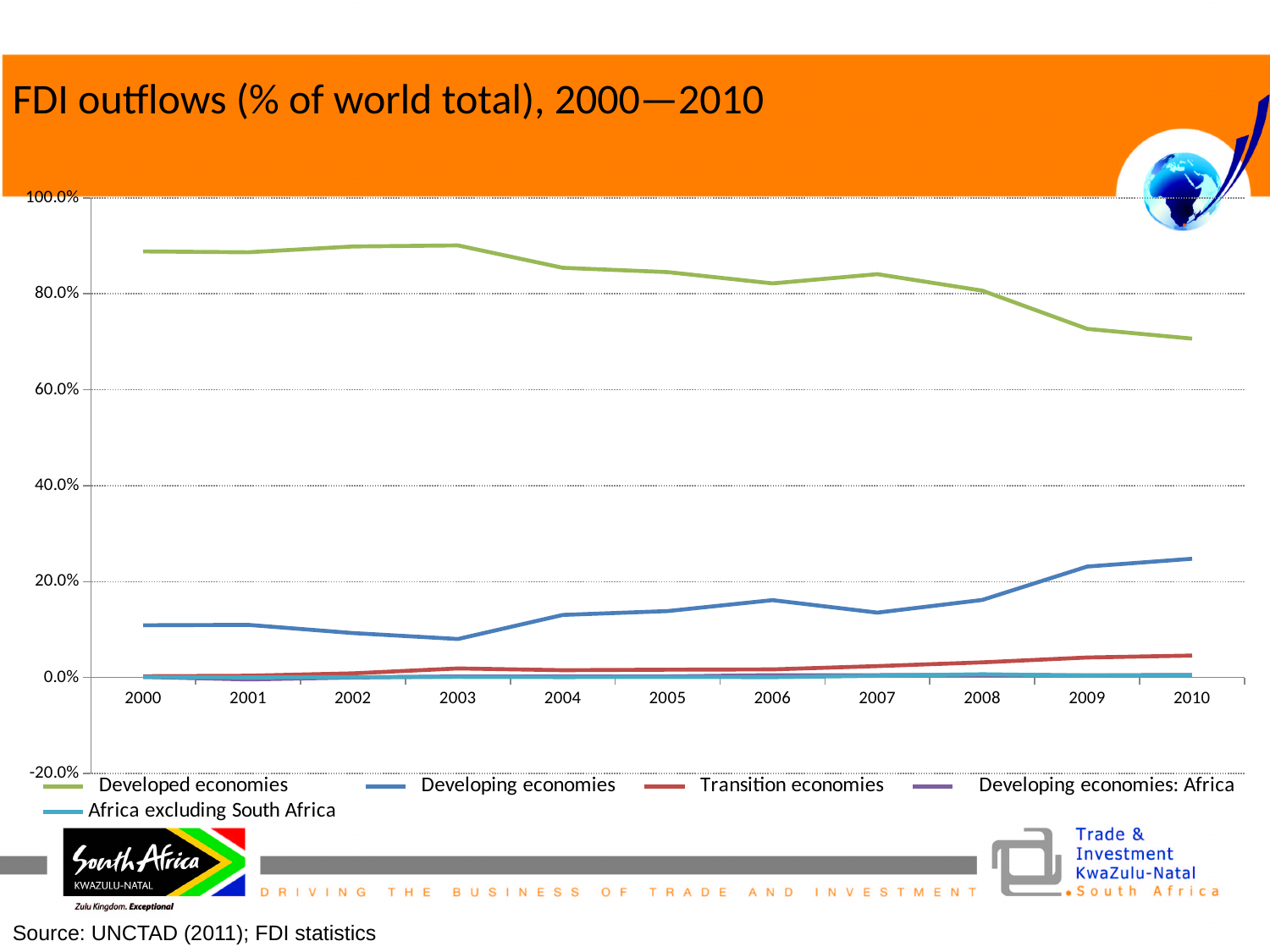
What kind of chart is shown on the slide? line chart How many series does the legend list? 5 In 2005, which is larger: Developed economies or Developing economies? Developed economies Which series has the highest value in 2010? Developed economies Is the value for Developed economies in 2000 greater or less than 80.0%? greater Is the value for Developing economies in 2000 greater or less than 20.0%? less Does the Developed economies line rise or fall from 2000 to 2010? fall Is the value for Developing economies in 2010 greater or less than 20.0%? greater What is the title of the chart? FDI outflows (% of world total), 2000—2010 Does the Developing economies line rise or fall from 2003 to 2010? rise How many years are plotted along the x axis? 11